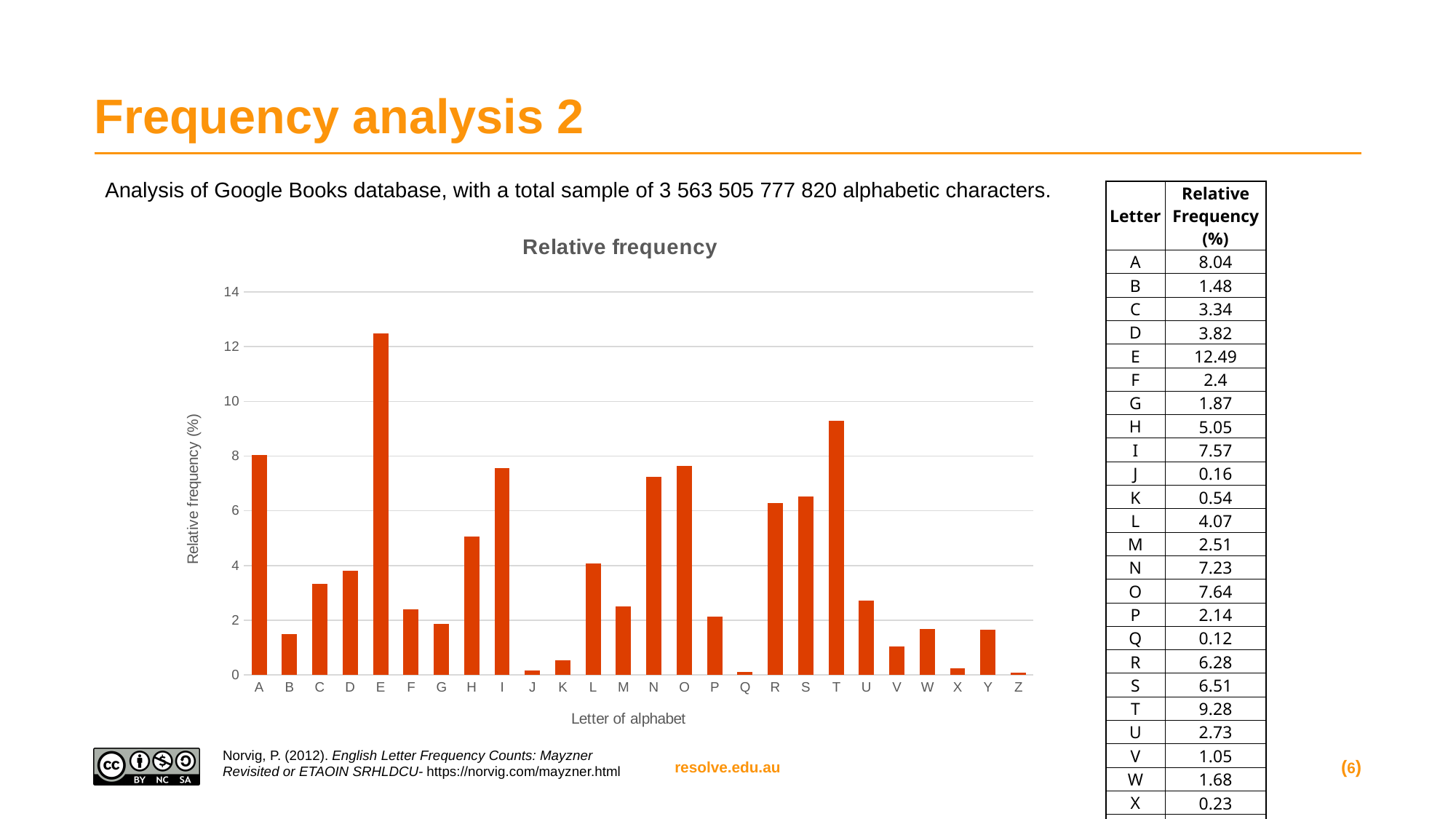
What is the relative frequency (%) of the letter E? 12.49 Is the value for T greater or less than 8? greater What is the relative frequency (%) of the letter T? 9.28 How many letters (categories) are plotted along the x axis of the chart? 26 Is the value for B greater or less than 2? less What is the title of the chart? Relative frequency Which has the larger relative frequency, T or E? E Which letter has the highest relative frequency in the chart? E Is the value for N greater or less than 6? greater Which has the larger relative frequency, H or L? H What kind of chart is shown on the slide? bar chart What is the difference between the relative frequency of E and that of T? 3.21